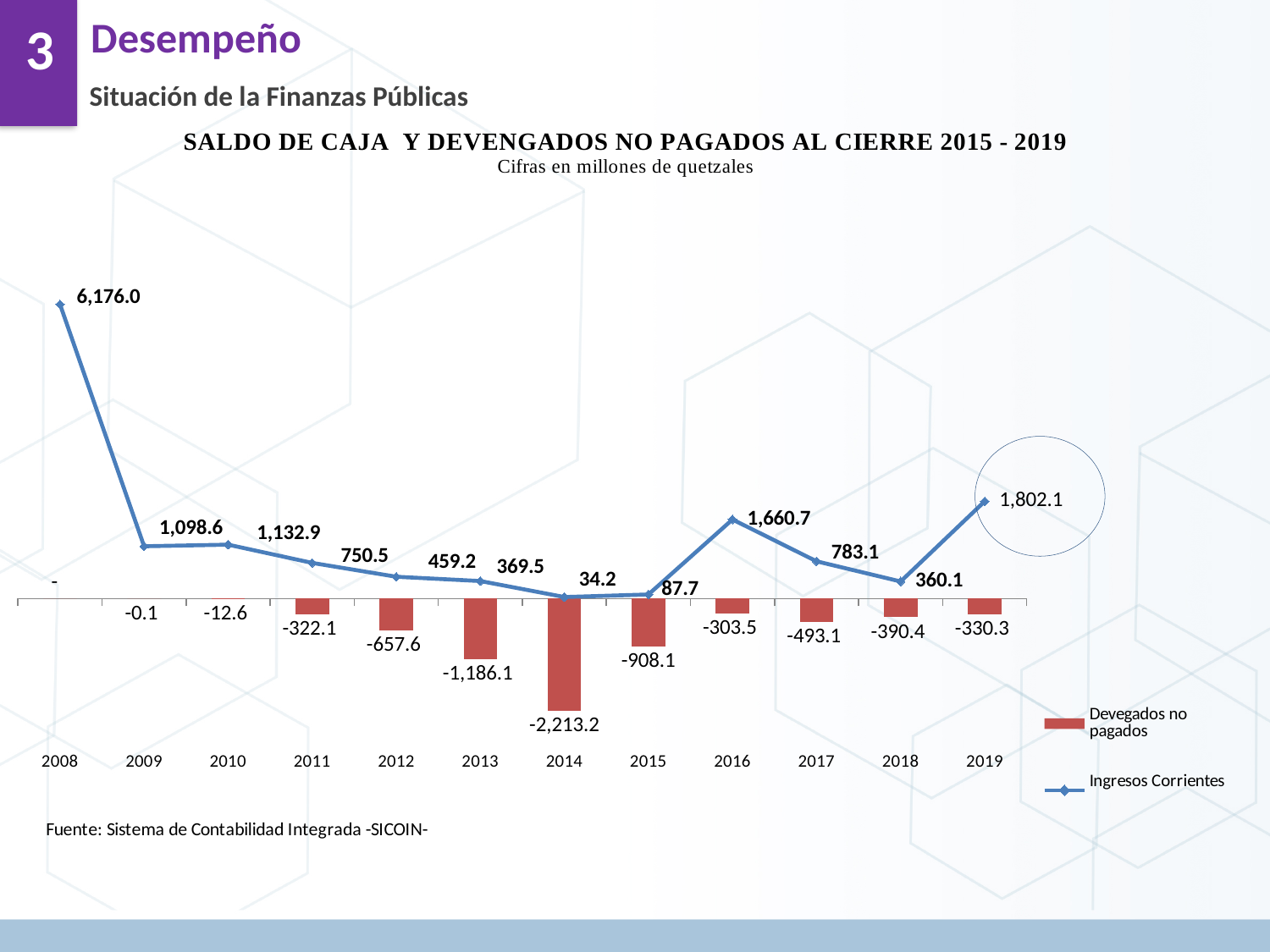
In which year is Ingresos Corrientes lowest? 2014 What is the value of Devegados no pagados for 2017? -493.1 Which year has the larger Ingresos Corrientes value, 2011 or 2018? 2011 What is the value of Ingresos Corrientes for 2019? 1,802.1 What is the value of Ingresos Corrientes for 2008? 6,176.0 In which year does Devegados no pagados reach its most negative value? 2014 Does Ingresos Corrientes rise or fall from 2018 to 2019? rise What is the value of Devegados no pagados for 2014? -2,213.2 In which year is Ingresos Corrientes highest? 2008 How many years are shown on the x axis? 12 How many series does the legend list? 2 What is the difference between Ingresos Corrientes in 2016 and in 2017? 877.6